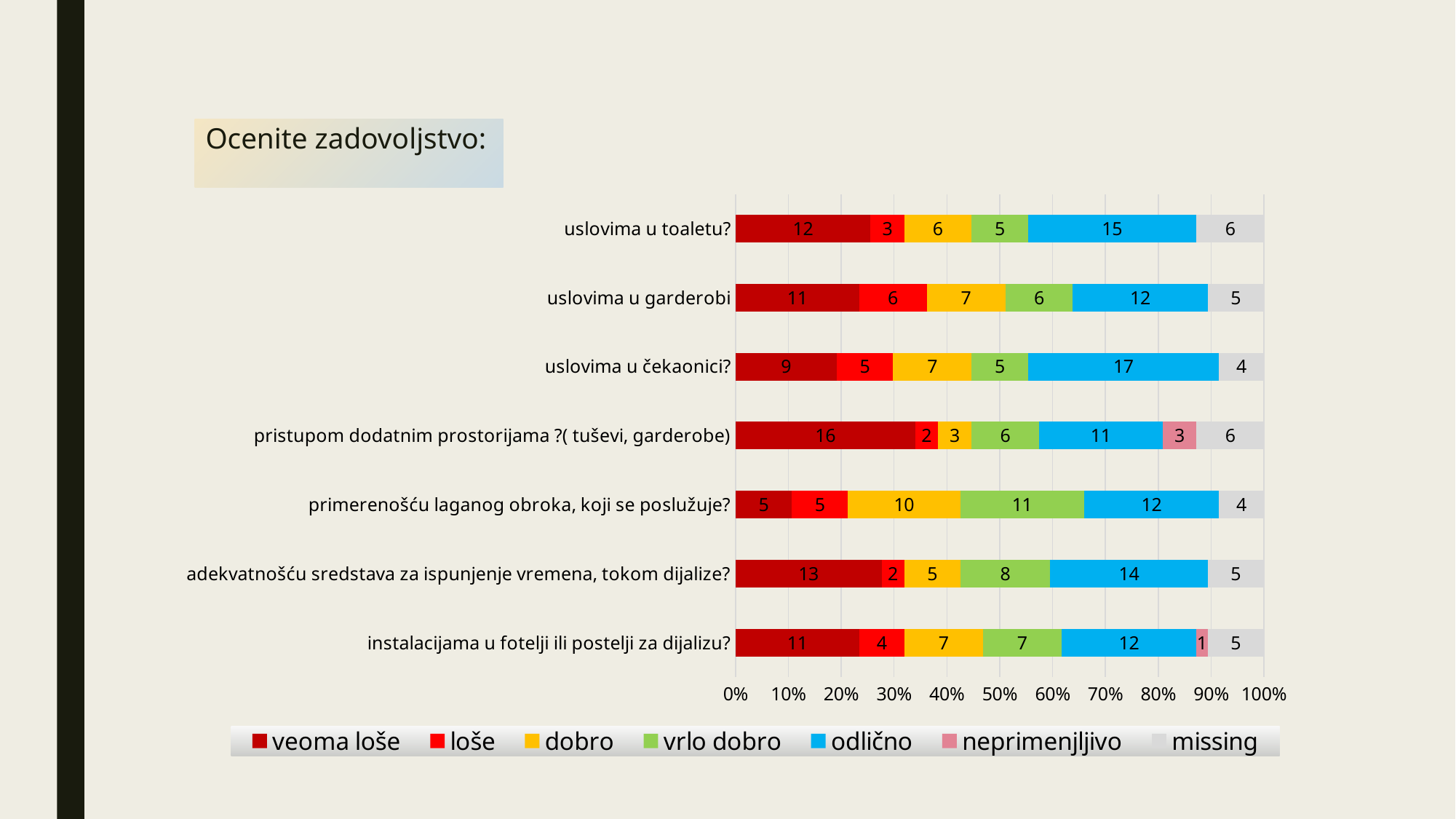
How many categories are shown on the chart? 7 What is the value for "neprimenjljivo" in the "instalacijama u fotelji ili postelji za dijalizu?" bar? 1 How many series does the legend list? 7 What is the value for "veoma loše" in the "pristupom dodatnim prostorijama ?( tuševi, garderobe)" bar? 16 What is the value for "odlično" in the "uslovima u čekaonici?" bar? 17 Which is larger: the "dobro" value for "primerenošću laganog obroka, koji se poslužuje?" or for "uslovima u garderobi"? primerenošću laganog obroka, koji se poslužuje? What kind of chart is shown on the slide? stacked bar chart What is the value for "vrlo dobro" in the "primerenošću laganog obroka, koji se poslužuje?" bar? 11 Which category has the highest value for "veoma loše"? pristupom dodatnim prostorijama ?( tuševi, garderobe) Which category has the lowest value for "veoma loše"? primerenošću laganog obroka, koji se poslužuje? What is the total of all segments in the "uslovima u toaletu?" bar? 47 What is the difference between the "odlično" values for "uslovima u čekaonici?" and "uslovima u toaletu?"? 2